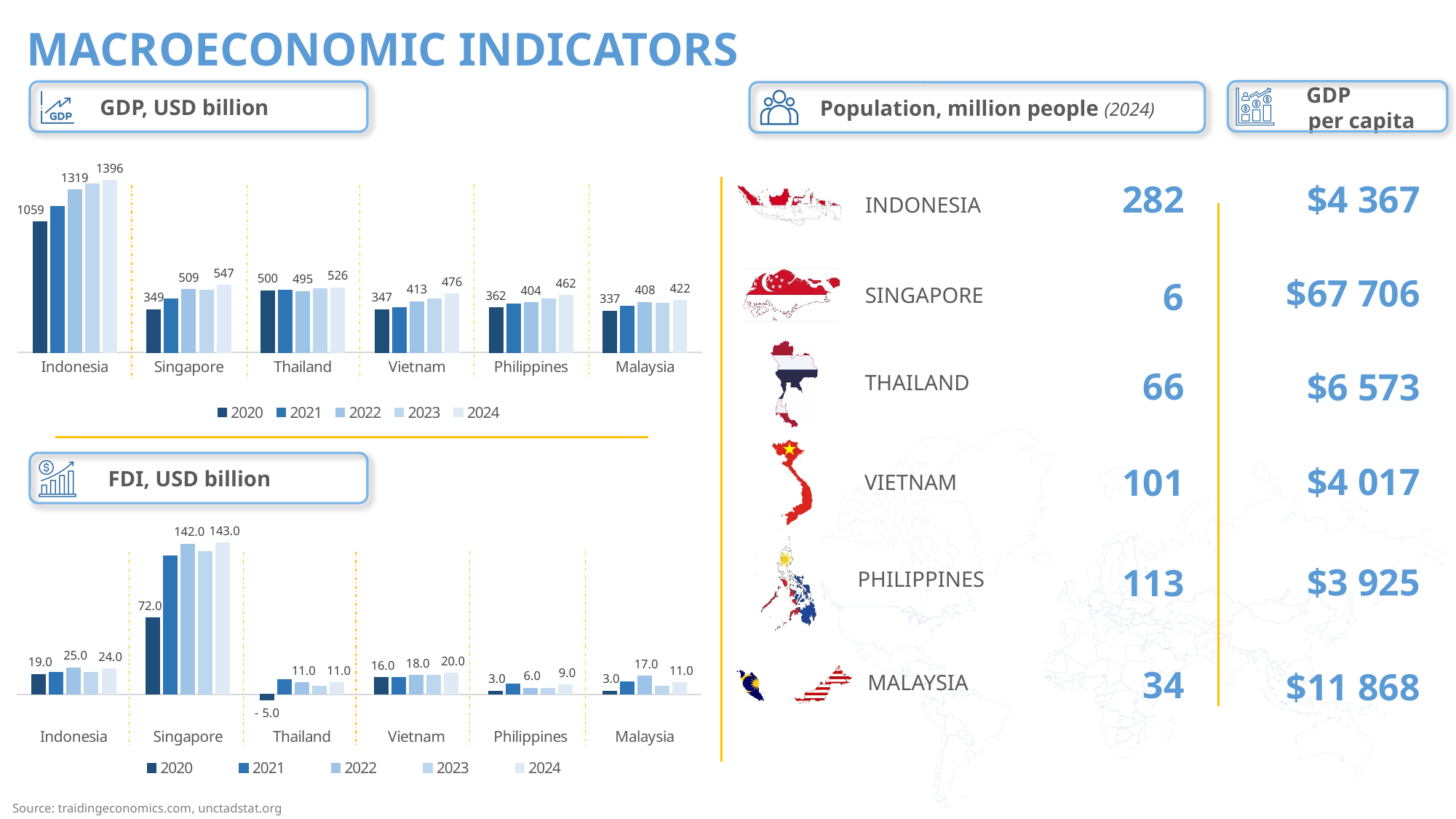
In the GDP, USD billion chart, how many series does the legend list? 5 In the FDI, USD billion chart, what is the 2022 FDI value for Singapore? 142.0 In the GDP, USD billion chart, what is the 2024 GDP value for Indonesia? 1396 In the GDP, USD billion chart, what is the 2020 GDP value for Thailand? 500 In the GDP, USD billion chart, which country has the highest GDP in 2024? Indonesia In the FDI, USD billion chart, is the 2024 FDI value for Indonesia larger or smaller than the 2024 value for Vietnam? larger In the GDP, USD billion chart, which country has the lowest GDP in 2020? Malaysia What type of chart is the FDI, USD billion chart? Bar chart In the FDI, USD billion chart, which country has the highest FDI in 2024? Singapore In the FDI, USD billion chart, what is the 2020 FDI value for Thailand? -5.0 In the FDI, USD billion chart, how many countries are shown on the x axis? 6 In the GDP, USD billion chart, what is the difference between Vietnam's 2024 and 2020 GDP values? 129